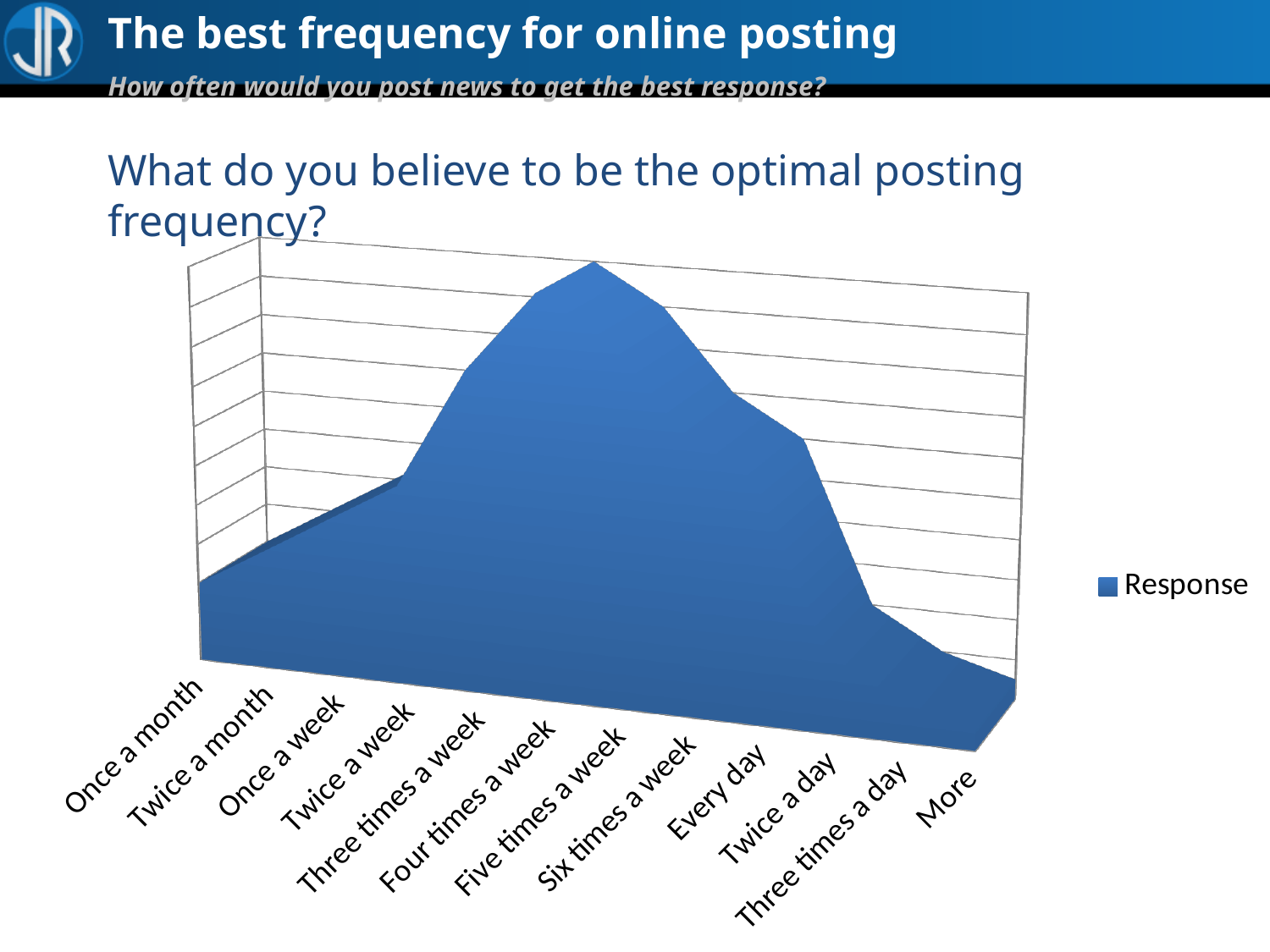
How many posting-frequency categories are shown along the x axis of the chart? 12 What is the name of the series shown in the chart's legend? Response Which posting frequency has the highest response in the chart? Four times a week What is the first category on the chart's x axis? Once a month Which has the larger response: Once a month or Four times a week? Four times a week Which has the larger response: Once a month or More? Once a month Do the values rise or fall from Once a month to Four times a week along the x axis? rise Which posting frequency has the lowest response in the chart? More Do the values rise or fall from Six times a week to More along the x axis? fall Which has the larger response: Three times a week or Three times a day? Three times a week How many series does the chart's legend list? 1 What kind of chart is shown on the slide? area chart